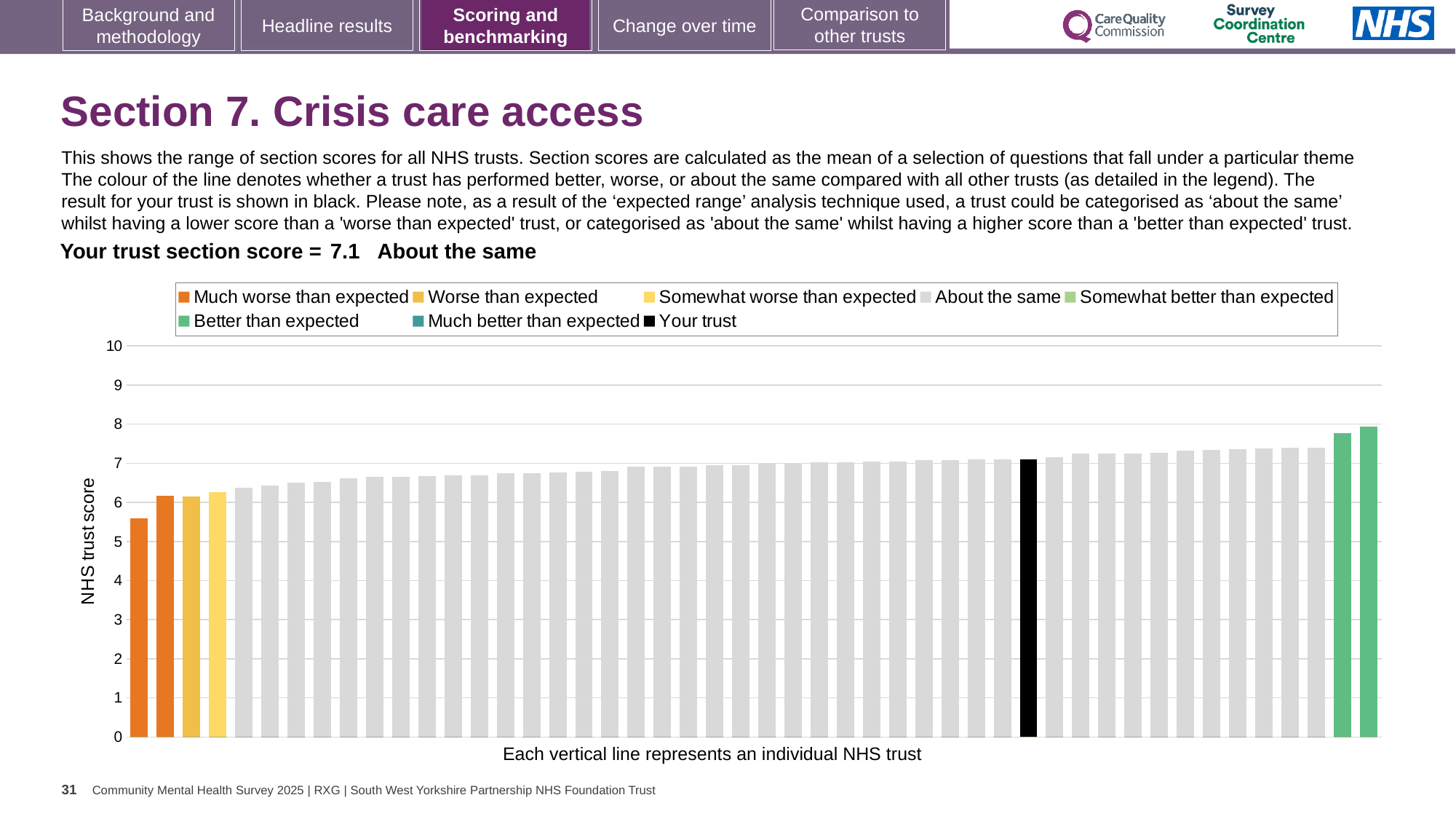
Do the bar values rise or fall from left to right along the x axis? rise What is the section score for your trust shown on the slide? 7.1 How many bars are coloured as 'Better than expected' (green)? 2 What colour is the bar representing your trust? black How many bars are coloured as 'Much worse than expected' (orange)? 2 What kind of chart is shown on the slide? bar chart Which category is your trust placed in for this section? About the same Is the value of the lowest bar in the chart greater or less than 6? less What is the label on the vertical axis of the chart? NHS trust score How many entries does the chart legend list? 8 Is the value of the black bar (your trust) greater or less than 7? greater